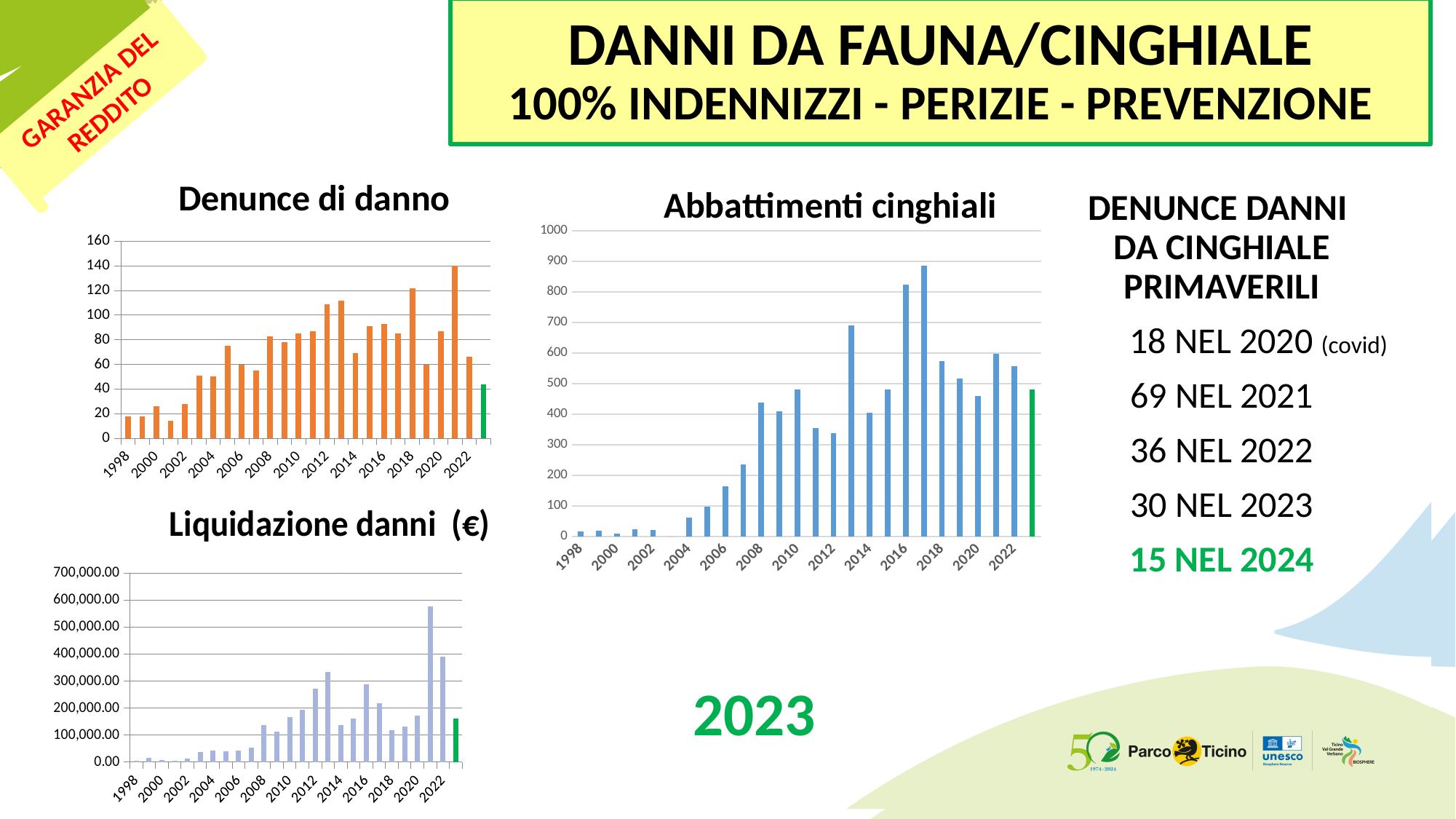
In the "Denunce di danno" chart, which year has the highest bar? 2021 In the "Abbattimenti cinghiali" chart, which year has the highest bar? 2017 In the "Liquidazione danni (€)" chart, which year has the highest bar? 2021 What colour is the last bar (2023) in each of the three charts? green In the "Abbattimenti cinghiali" chart, is the value for 2017 greater or less than 800? greater In the "Liquidazione danni (€)" chart, is the value for 2021 greater or less than 500,000.00? greater In the "Abbattimenti cinghiali" chart, is the value for 2004 greater or less than 100? less What type of chart is "Denunce di danno"? bar chart In the "Abbattimenti cinghiali" chart, do the values generally rise or fall from 1998 to 2010? rise In the "Abbattimenti cinghiali" chart, which is larger, the value for 2016 or the value for 2017? 2017